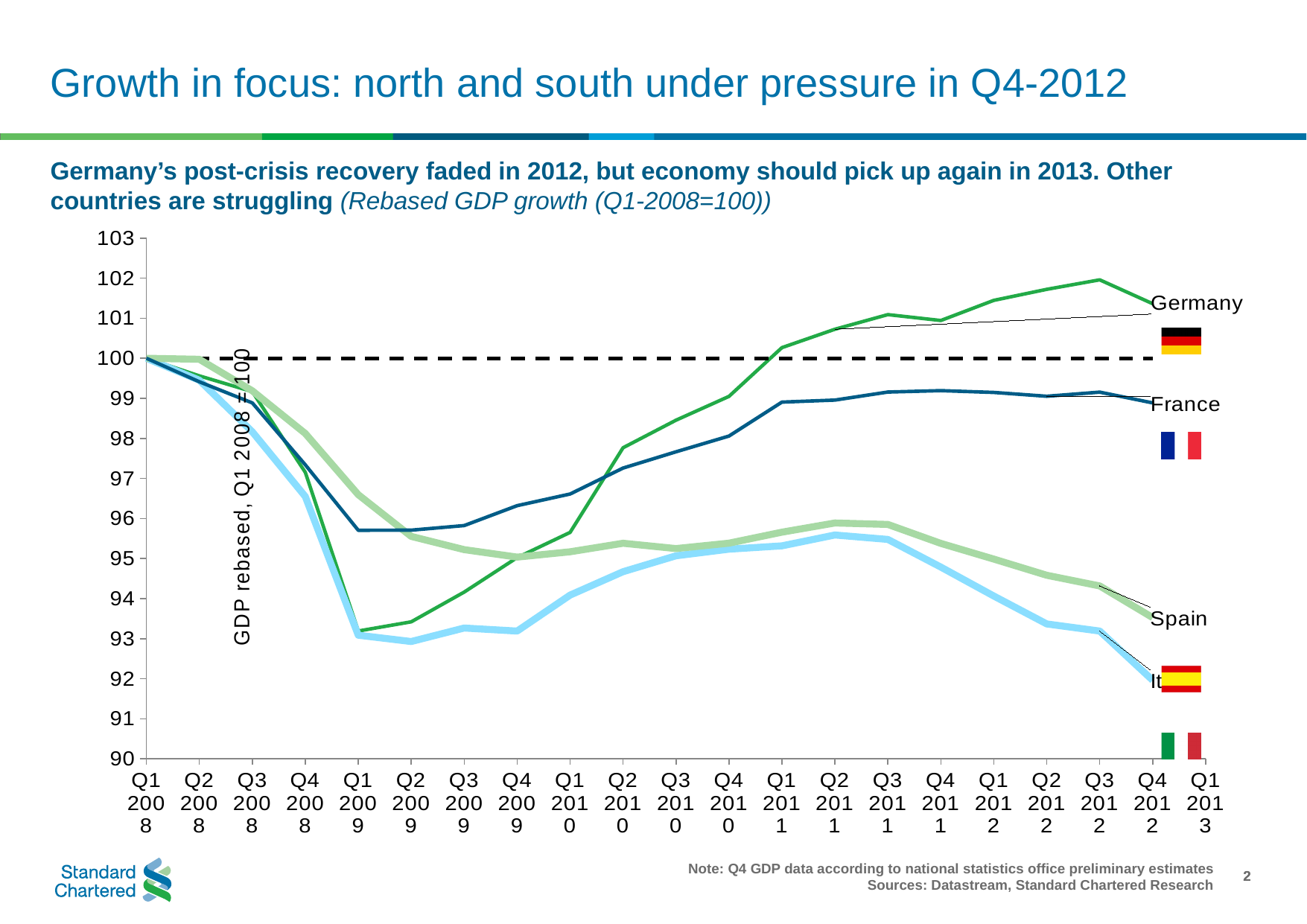
Which is larger at Q4 2012, the value for Germany or the value for France? Germany Is the value for Germany at Q1 2009 greater or less than 94? less Is the value for Spain at Q4 2012 greater or less than 94? less What kind of chart is shown on the slide? line chart Which country has the highest rebased GDP value at Q4 2012? Germany What is the rebased GDP value for all countries at Q1 2008? 100 How many countries are plotted as lines on the chart? 4 Is the value for France at Q4 2012 greater or less than 100? less Which country has the lowest rebased GDP value at Q4 2012? Italy What value does the horizontal dashed line mark on the chart? 100 Does the Spain line rise or fall between Q3 2011 and Q4 2012? fall